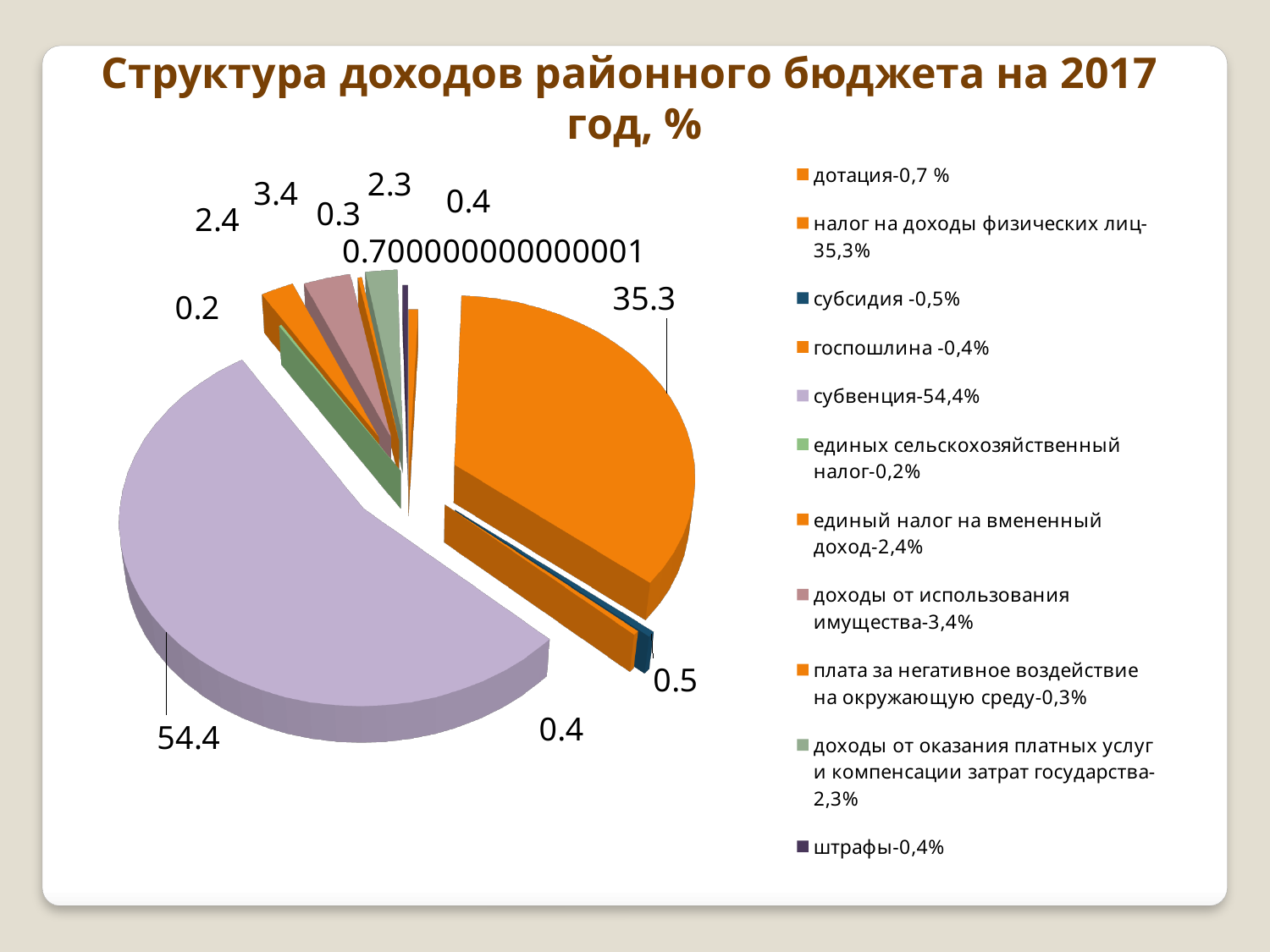
What value is labelled on the slice for субвенция? 54.4 Which category has the largest slice of the pie? субвенция By how much does the value for субвенция exceed the value for налог на доходы физических лиц? 19.1 Which category has the smallest slice of the pie? единых сельскохозяйственный налог What value is labelled on the slice for единый налог на вмененный доход? 2.4 What kind of chart is shown on the slide? pie chart How many categories does the legend list? 11 What is the title of the chart? Структура доходов районного бюджета на 2017 год, % What value is labelled on the slice for субсидия? 0.5 What value is labelled on the slice for налог на доходы физических лиц? 35.3 What value is labelled on the slice for доходы от использования имущества? 3.4 Which is larger: the slice for доходы от использования имущества or the slice for доходы от оказания платных услуг и компенсации затрат государства? доходы от использования имущества